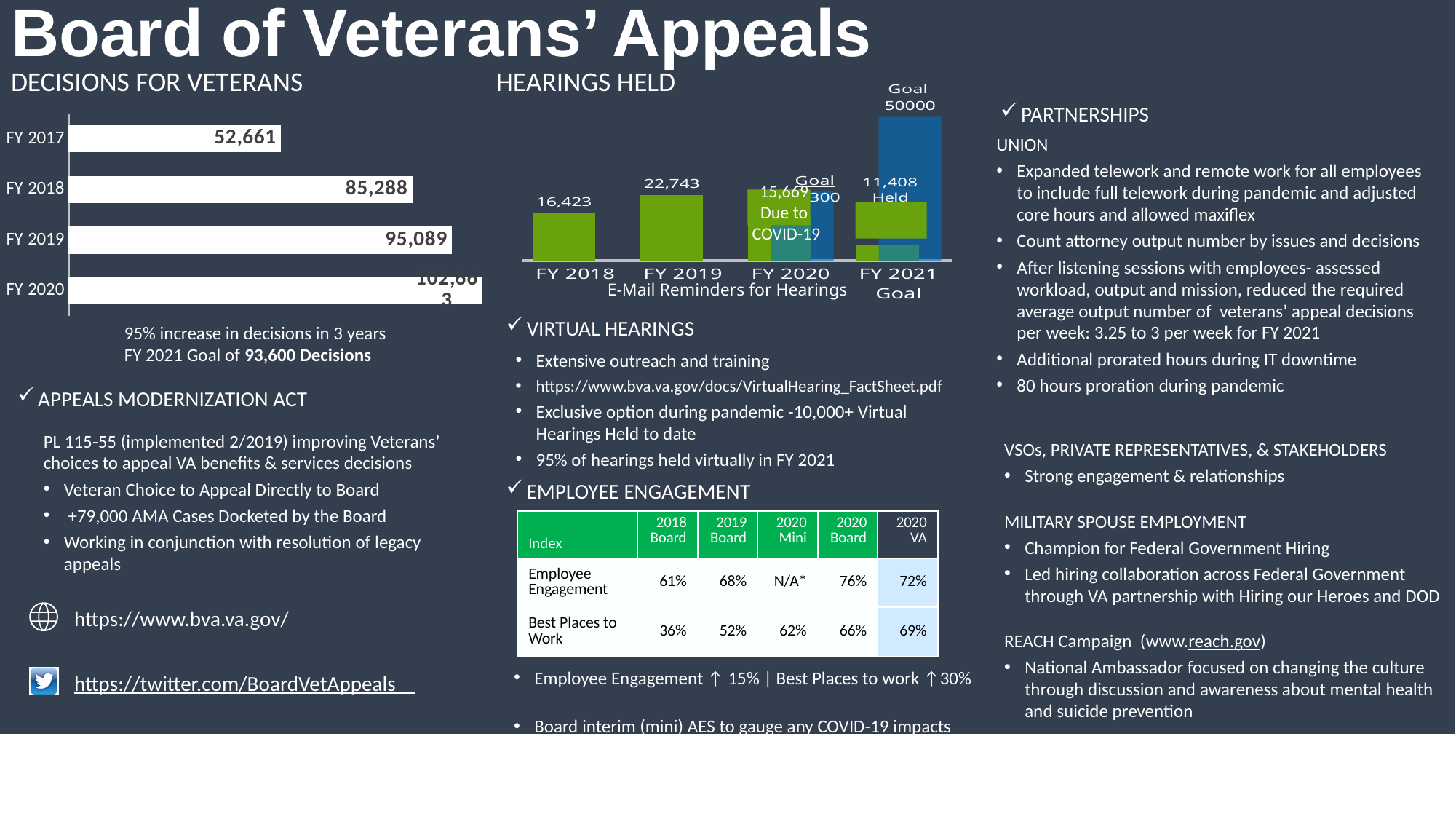
In the DECISIONS FOR VETERANS chart, what is the value for FY 2017? 52,661 In the DECISIONS FOR VETERANS chart, what is the value for FY 2019? 95,089 In the DECISIONS FOR VETERANS chart, which fiscal year has the lowest number of decisions? FY 2017 What kind of chart is the DECISIONS FOR VETERANS chart? Bar chart In the HEARINGS HELD chart, which is larger, the FY 2018 value or the FY 2019 value? FY 2019 In the DECISIONS FOR VETERANS chart, which fiscal year has the highest number of decisions? FY 2020 In the DECISIONS FOR VETERANS chart, what is the value for FY 2018? 85,288 In the DECISIONS FOR VETERANS chart, what is the difference between the FY 2019 and FY 2018 values? 9,801 In the DECISIONS FOR VETERANS chart, do the values rise or fall from FY 2017 to FY 2020? Rise In the HEARINGS HELD chart, what is the value for FY 2018? 16,423 In the HEARINGS HELD chart, what is the value for FY 2019? 22,743 How many fiscal years are shown in the DECISIONS FOR VETERANS chart? 4